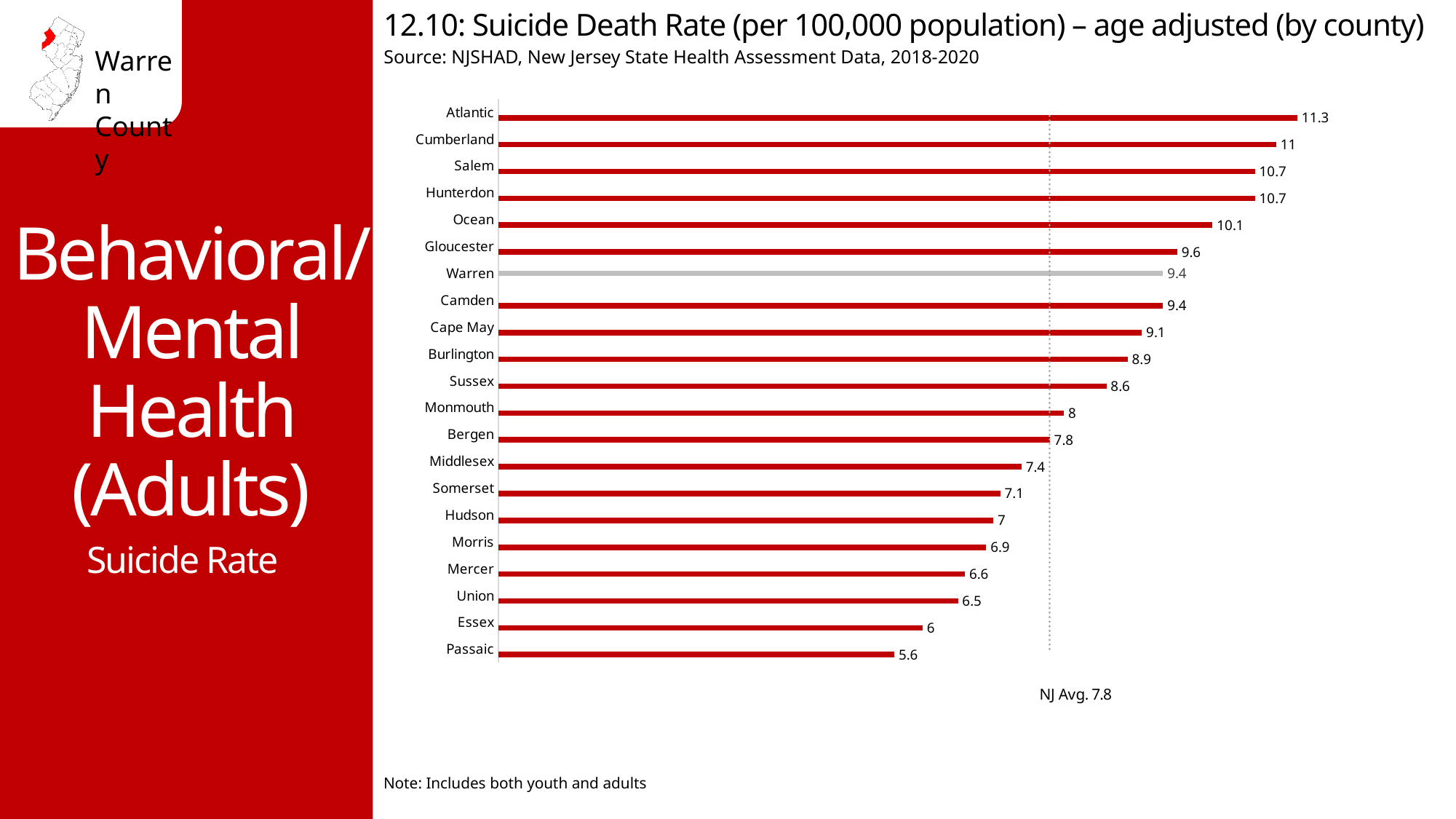
How much higher is Warren county's suicide death rate than the NJ average of 7.8? 1.6 What type of chart is shown on the slide? Bar chart Which county's bar is shown in grey rather than red? Warren Which county has the highest suicide death rate? Atlantic What is the suicide death rate for Hudson county? 7 Which county has a higher suicide death rate, Ocean or Gloucester? Ocean What is the suicide death rate for Atlantic county? 11.3 What is the difference between the suicide death rates of Atlantic and Passaic? 5.7 Which county has the lowest suicide death rate? Passaic What is the NJ average suicide death rate shown on the chart? 7.8 How many counties are shown in the chart? 21 What is the suicide death rate for Warren county? 9.4